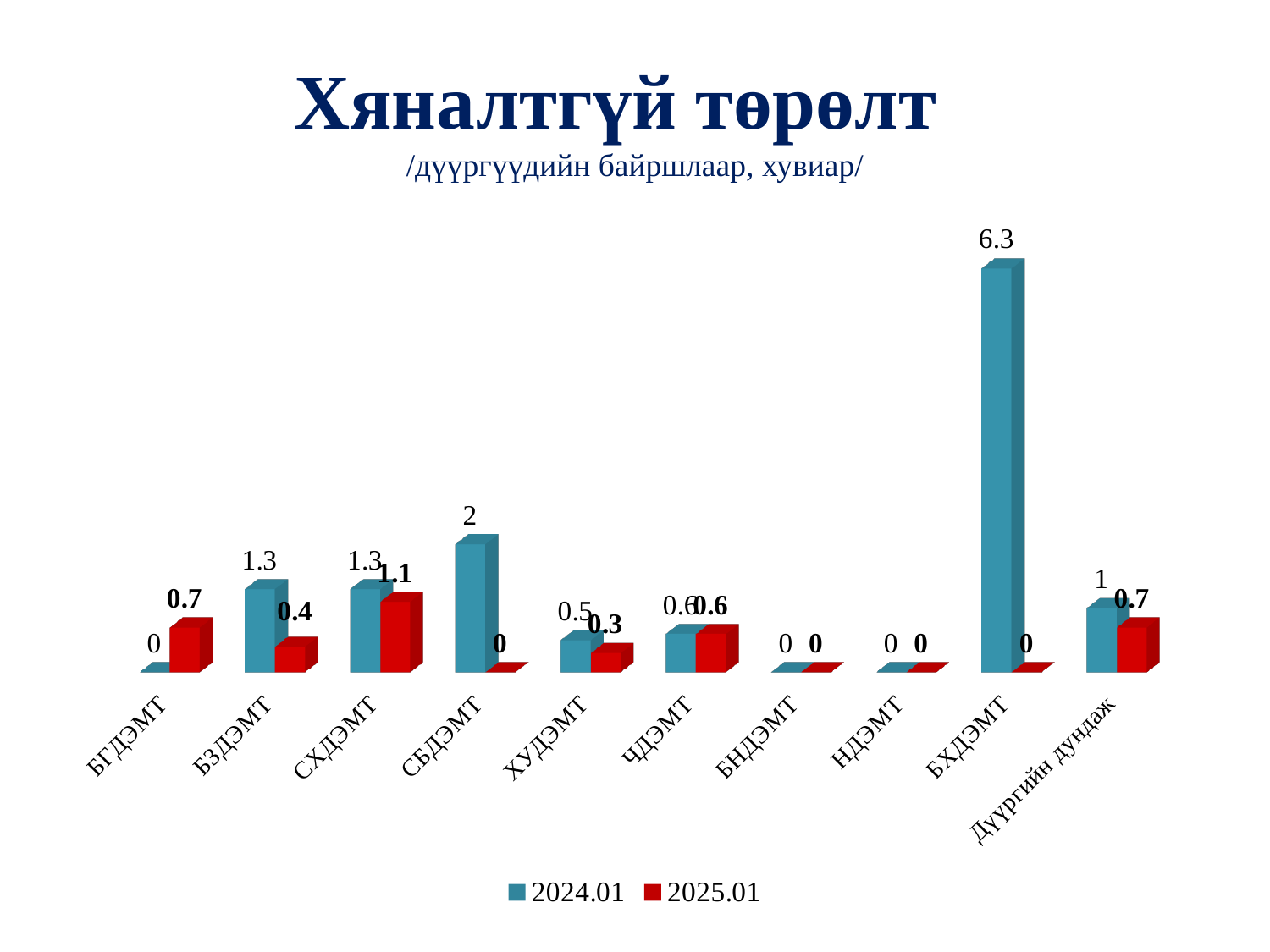
How many series does the legend list? 2 What kind of chart is shown on the slide? Bar chart Which category has the highest 2025.01 value? СХДЭМТ What is the 2025.01 value for БГДЭМТ? 0.7 What is the 2024.01 value for СБДЭМТ? 2 Which category has the highest 2024.01 value? БХДЭМТ What is the difference between the 2024.01 and 2025.01 values for БЗДЭМТ? 0.9 What is the 2024.01 value for БХДЭМТ? 6.3 What is the 2025.01 value for СХДЭМТ? 1.1 What is the title of the chart on the slide? Хяналтгүй төрөлт How many categories are shown on the x axis? 10 Which is larger for ХУДЭМТ, the 2024.01 value or the 2025.01 value? 2024.01